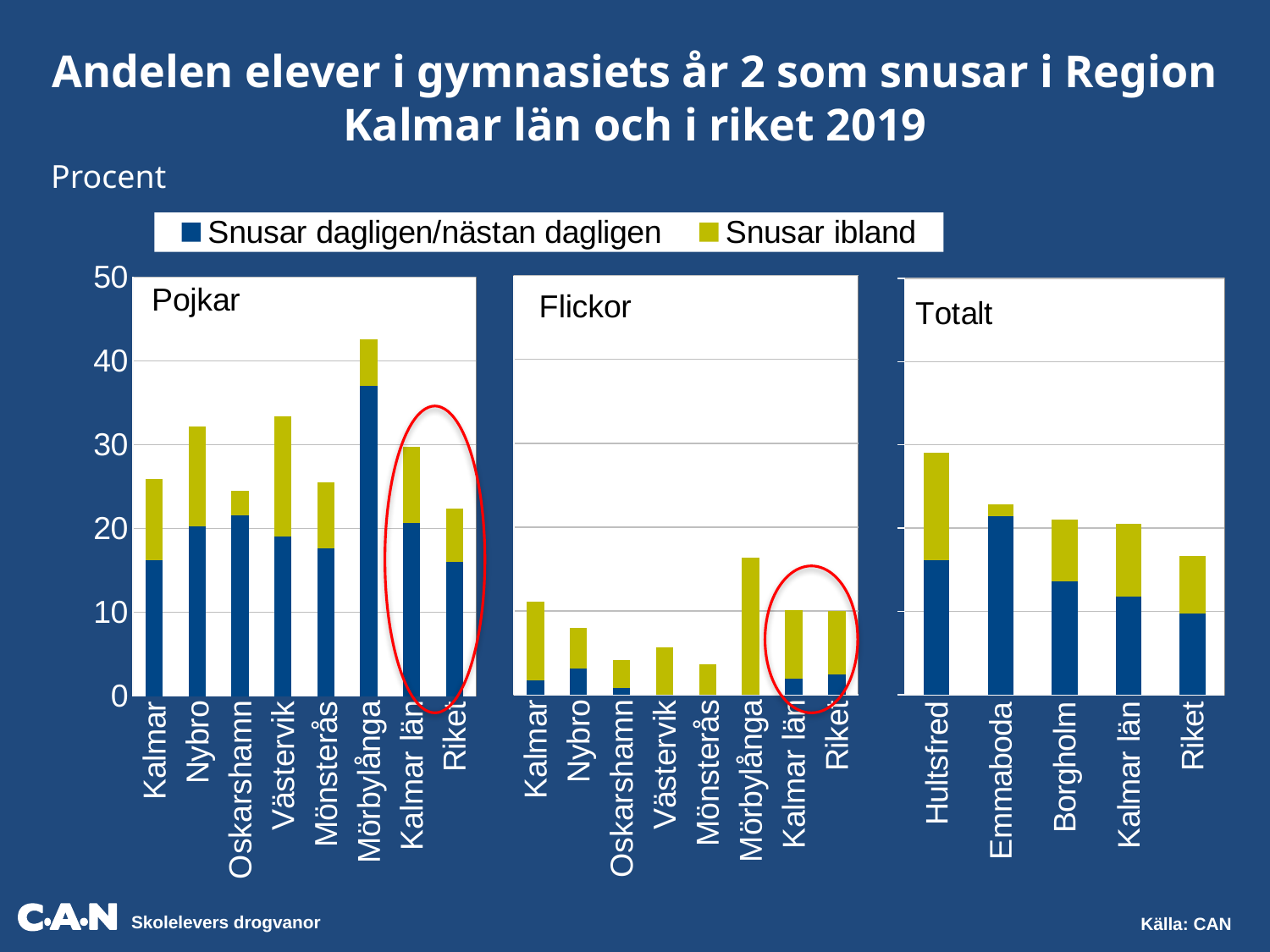
In the Totalt chart, which category has the lowest total bar? Riket In the Flickor chart, which category has the highest total bar? Mörbylånga How many series does the legend list? 2 In the Totalt chart, how many categories are shown on the x axis? 5 In the Totalt chart, do the total bar values rise or fall from left to right along the x axis? fall In the Flickor chart, is the total value for Nybro greater or less than 10? less In the Pojkar chart, how many categories are shown on the x axis? 8 In the Pojkar chart, is the total value for Mörbylånga greater or less than 40? greater In the Pojkar chart, which category has the highest total bar? Mörbylånga What kind of chart is shown on the slide? Stacked bar chart Which legend entry is shown in blue? Snusar dagligen/nästan dagligen In the Totalt chart, which category has the highest total bar? Hultsfred